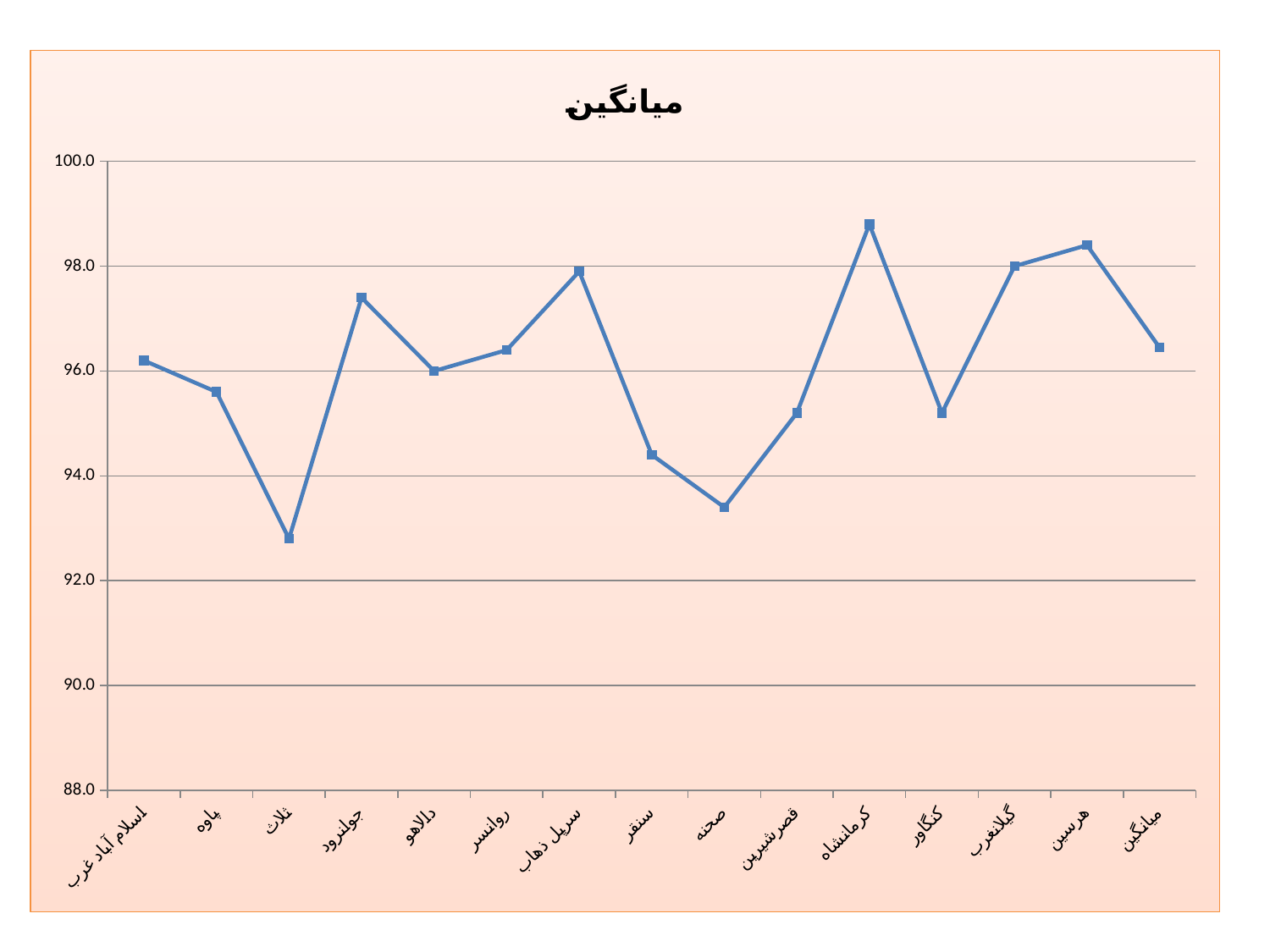
Which has the larger value, ثلاث or جوانرود? جوانرود Is the value for صحنه greater or less than 94.0? less Is the value for کرمانشاه greater or less than 98.0? greater What is the title of the chart? میانگین Is the value for جوانرود greater or less than 96.0? greater Does the line rise or fall from کرمانشاه to کنگاور? fall Which category has the highest value? کرمانشاه Which has the larger value, کرمانشاه or کنگاور? کرمانشاه Which category has the lowest value? ثلاث What kind of chart is shown on the slide? line chart How many categories are plotted along the x axis? 15